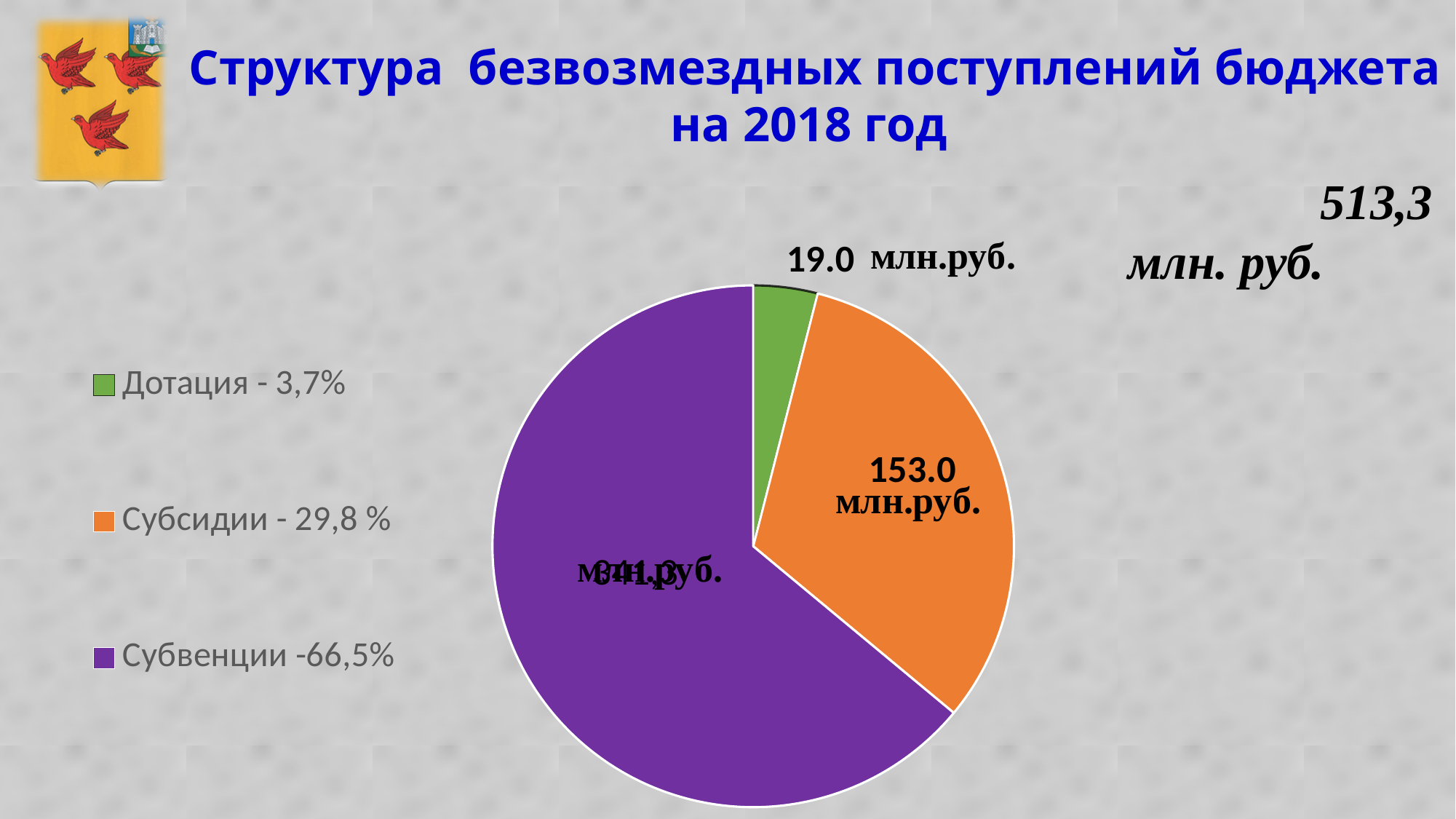
What share of the pie does Субвенции represent according to the legend? 66,5% What value is labelled on the Дотация slice? 19.0 млн.руб. Which category has the smallest slice of the pie? Дотация What share of the pie does Дотация represent according to the legend? 3,7% Which is larger, the Субсидии slice or the Дотация slice? Субсидии What value is labelled on the Субсидии slice? 153.0 млн.руб. What kind of chart is shown on the slide? pie chart How many slices does the pie chart have? 3 What share of the pie does Субсидии represent according to the legend? 29,8 % What is the difference between the Субсидии value and the Дотация value? 134.0 млн.руб. Which category has the largest slice of the pie? Субвенции What colour is the Субвенции slice? purple